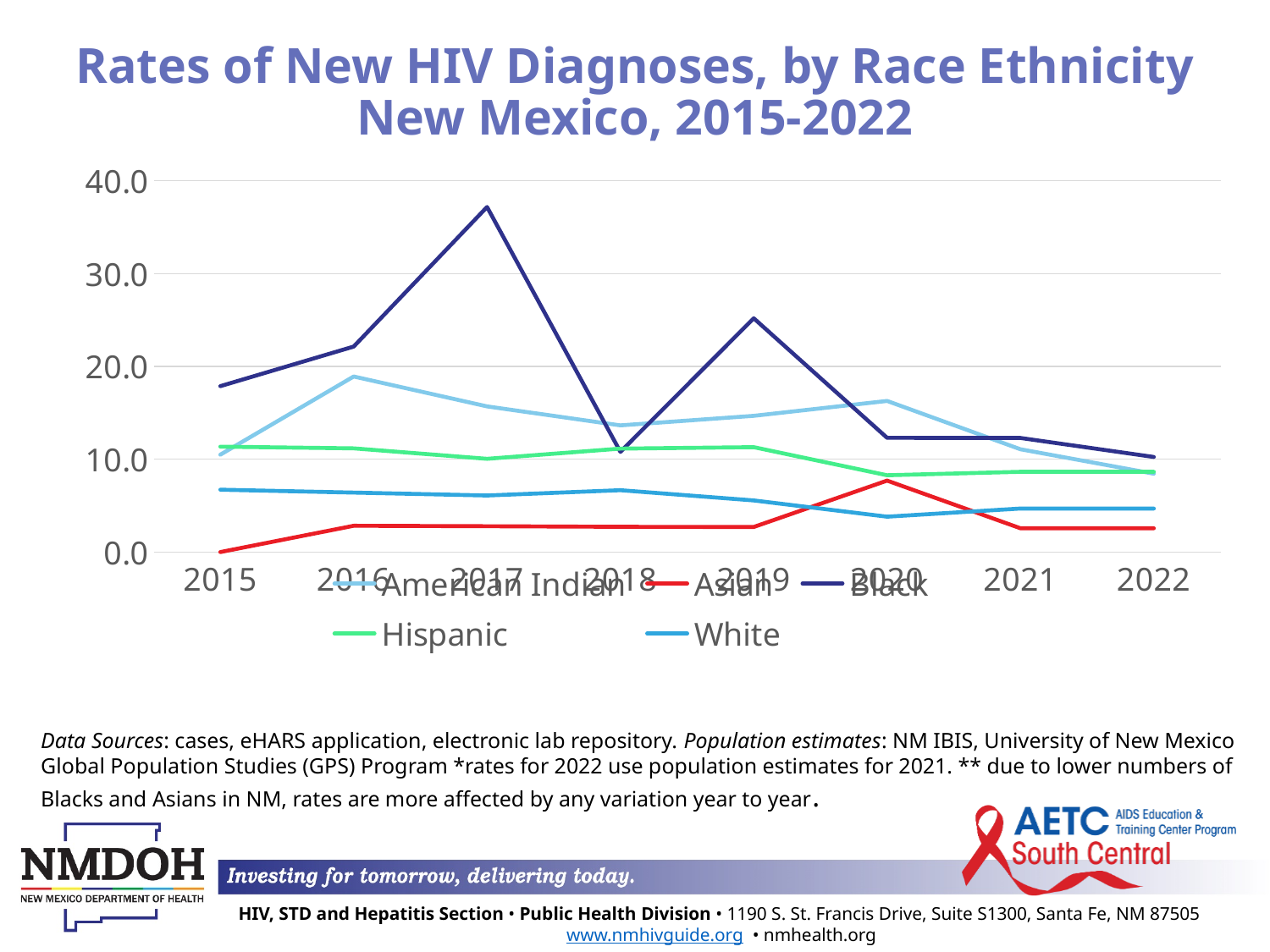
Which series has the highest rate in 2017? Black How many years are plotted along the x axis? 8 Which series has the lowest rate in 2015? Asian Is the value for Black in 2018 greater or less than 20? less Does the Black series rise or fall from 2020 to 2022? Fall What kind of chart is shown on the slide? Line chart Which is larger in 2015, the rate for Hispanic or the rate for Asian? Hispanic In which year does the Black series reach its highest value? 2017 Is the value for Black in 2017 greater or less than 30? greater How many series does the legend list? 5 Is the value for White in 2015 greater or less than 10? less What is the title of the chart? Rates of New HIV Diagnoses, by Race Ethnicity New Mexico, 2015-2022